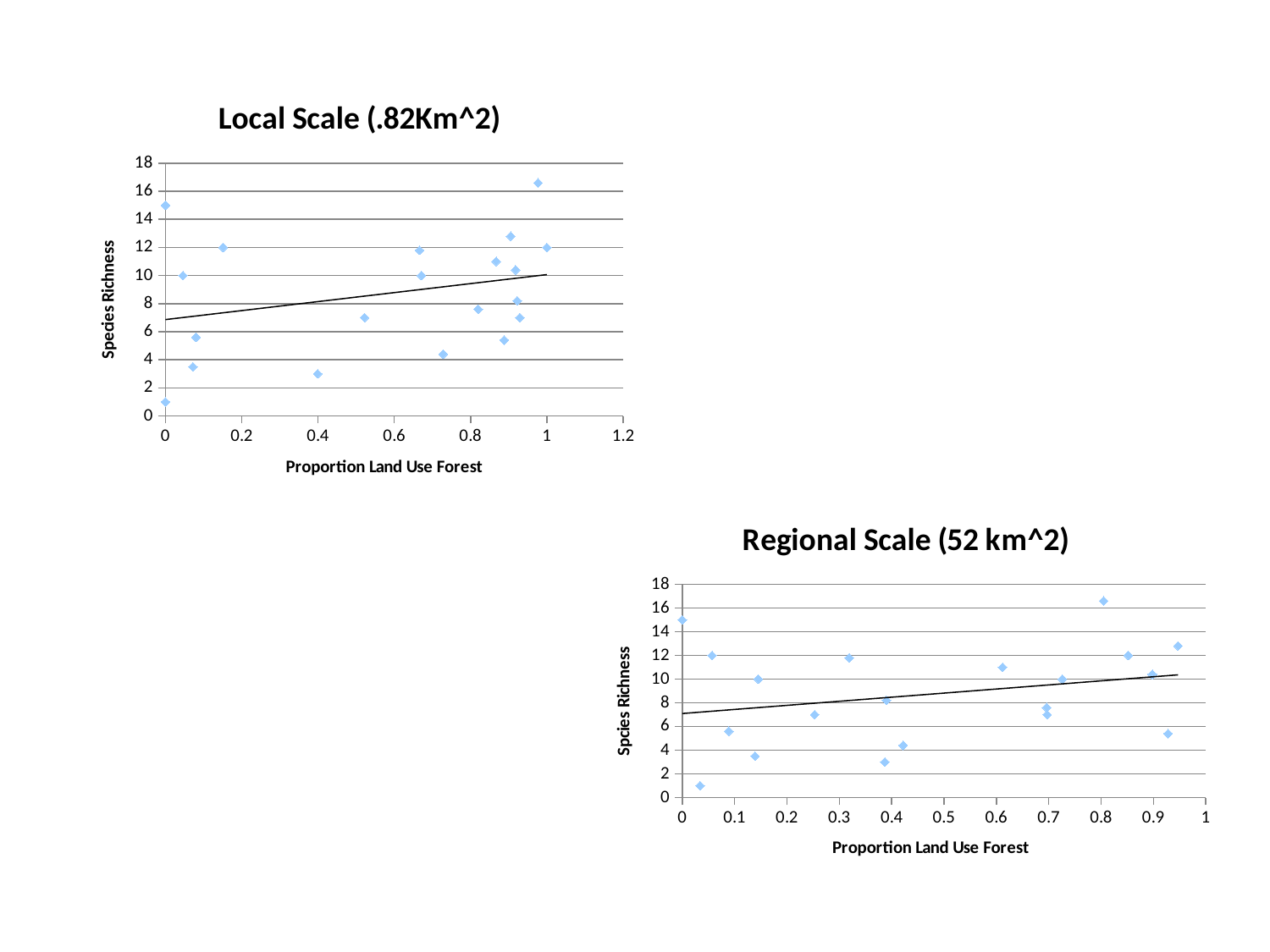
What kind of chart is the 'Regional Scale (52 km^2)' chart? scatter chart In the 'Local Scale (.82Km^2)' chart, which has the higher Species Richness: the topmost point at Proportion Land Use Forest 0 or the topmost point near 1? the point near 1 What is the maximum value shown on the y-axis of the 'Local Scale (.82Km^2)' chart? 18 In the 'Local Scale (.82Km^2)' chart, does the fitted trend line rise or fall as Proportion Land Use Forest increases? rises In the 'Local Scale (.82Km^2)' chart, is the Species Richness of the point at Proportion Land Use Forest 0.4 greater or less than 4? less In the 'Local Scale (.82Km^2)' chart, is the highest plotted Species Richness value greater or less than 16? greater In the 'Regional Scale (52 km^2)' chart, does the fitted trend line rise or fall as Proportion Land Use Forest increases? rises In the 'Regional Scale (52 km^2)' chart, is the Species Richness of the point near Proportion Land Use Forest 0.8 greater or less than 16? greater What kind of chart is the 'Local Scale (.82Km^2)' chart? scatter chart What is the x-axis label of the 'Regional Scale (52 km^2)' chart? Proportion Land Use Forest